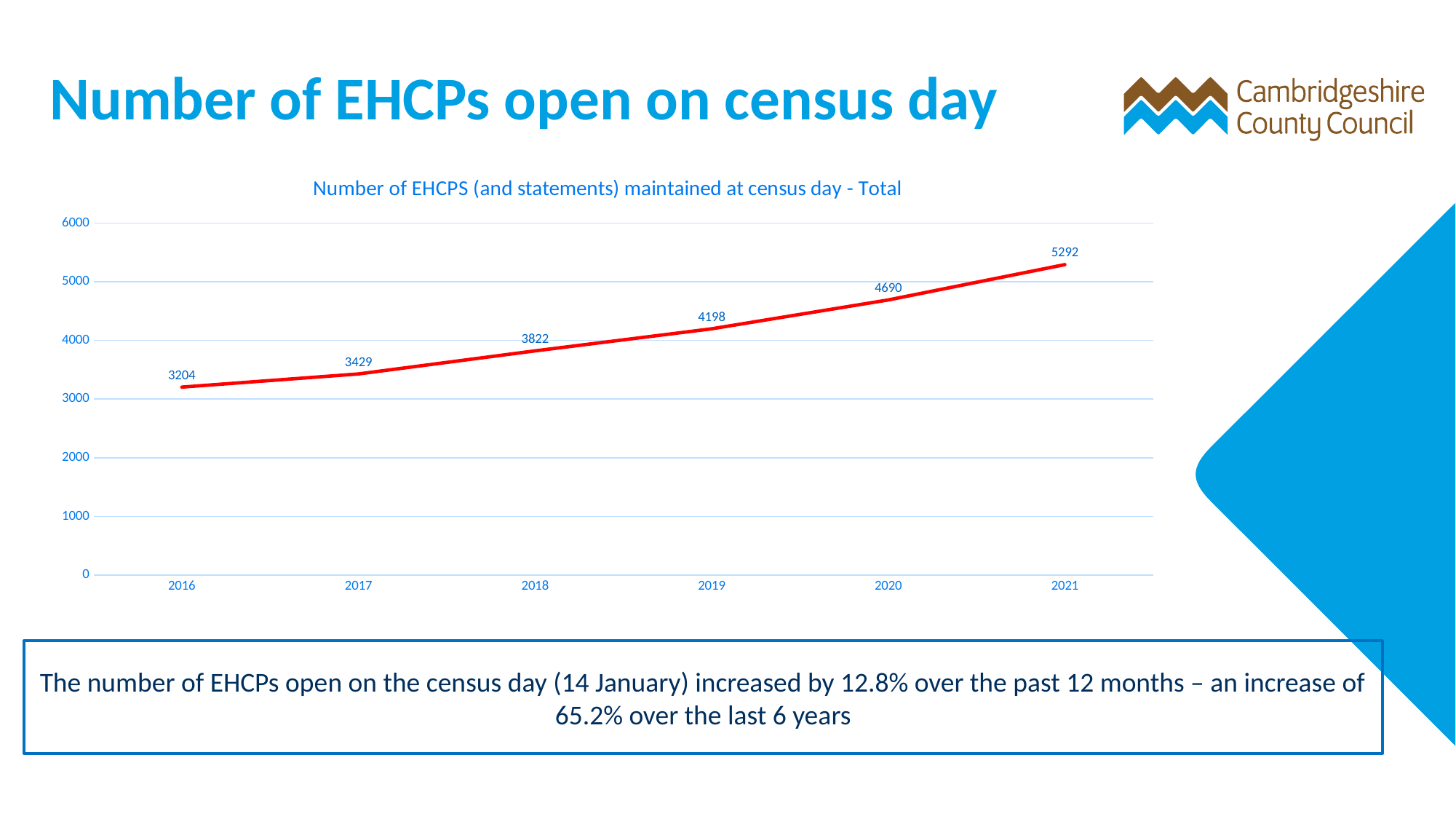
What kind of chart is shown on the slide? line chart Do the values rise or fall from 2016 to 2021? rise What is the number of EHCPs maintained at census day in 2021? 5292 What is the difference between the number of EHCPs in 2018 and in 2017? 393 Which year has a larger number of EHCPs, 2018 or 2020? 2020 Which year has the highest number of EHCPs maintained at census day? 2021 What is the number of EHCPs maintained at census day in 2016? 3204 Which year has the lowest number of EHCPs maintained at census day? 2016 How many years are plotted on the chart? 6 What is the number of EHCPs maintained at census day in 2019? 4198 Is the value for 2019 greater or less than 4000? greater What is the difference between the number of EHCPs in 2021 and in 2020? 602